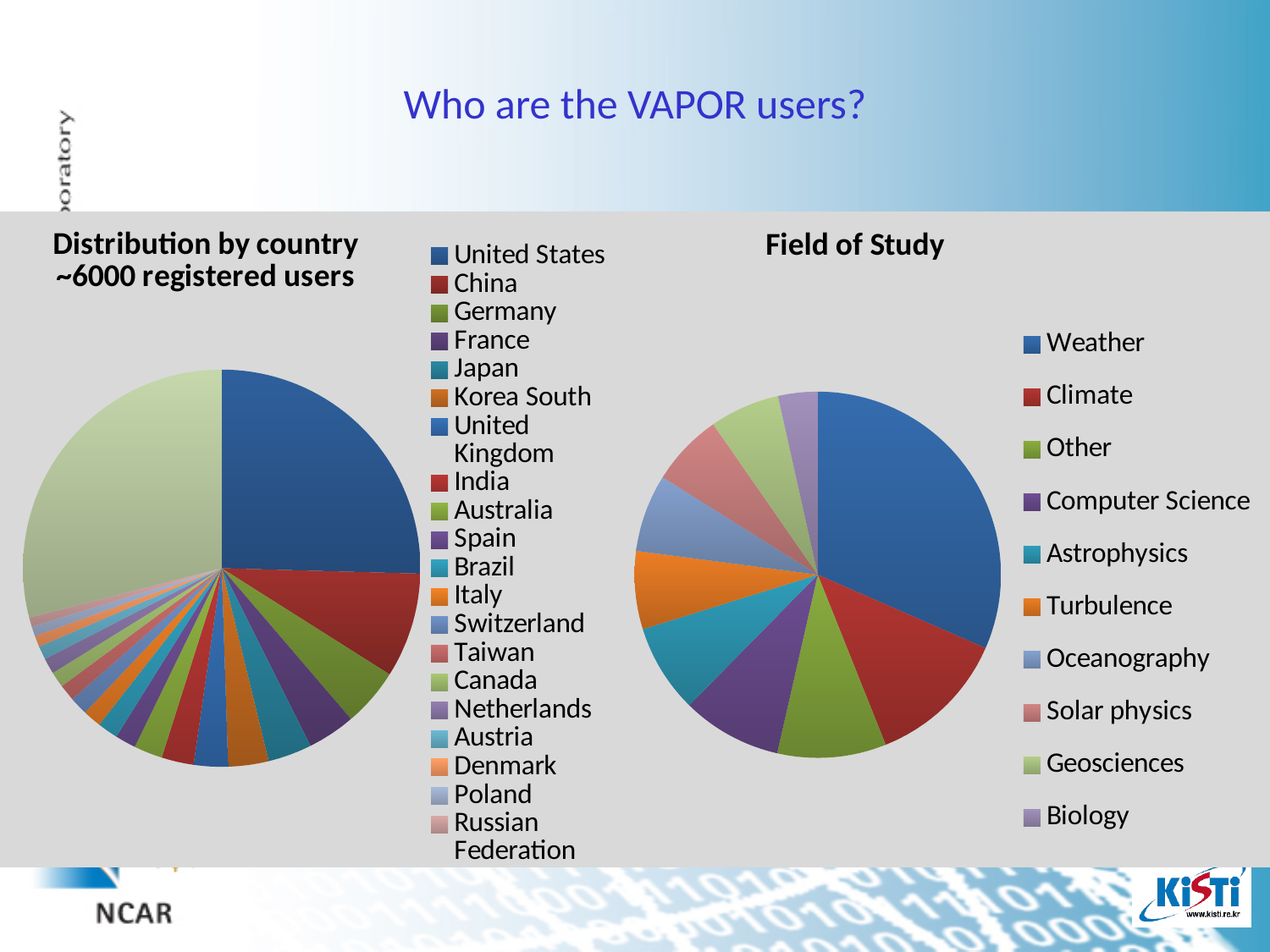
What is the title of the chart on the right side of the slide? Field of Study How many fields does the legend of the Field of Study chart list? 10 Approximately how many registered users does the Distribution by country chart title mention? ~6000 How many countries does the legend of the Distribution by country chart list? 20 In the Distribution by country chart, which slice is larger, United States or China? United States In the Field of Study chart, which field has the largest slice? Weather In the Distribution by country chart, which slice is larger, China or Germany? China In the Field of Study chart, which field has the smallest slice? Biology In the Field of Study chart, which slice is larger, Weather or Climate? Weather What kind of chart is the Field of Study chart? pie chart What kind of chart is the Distribution by country chart? pie chart